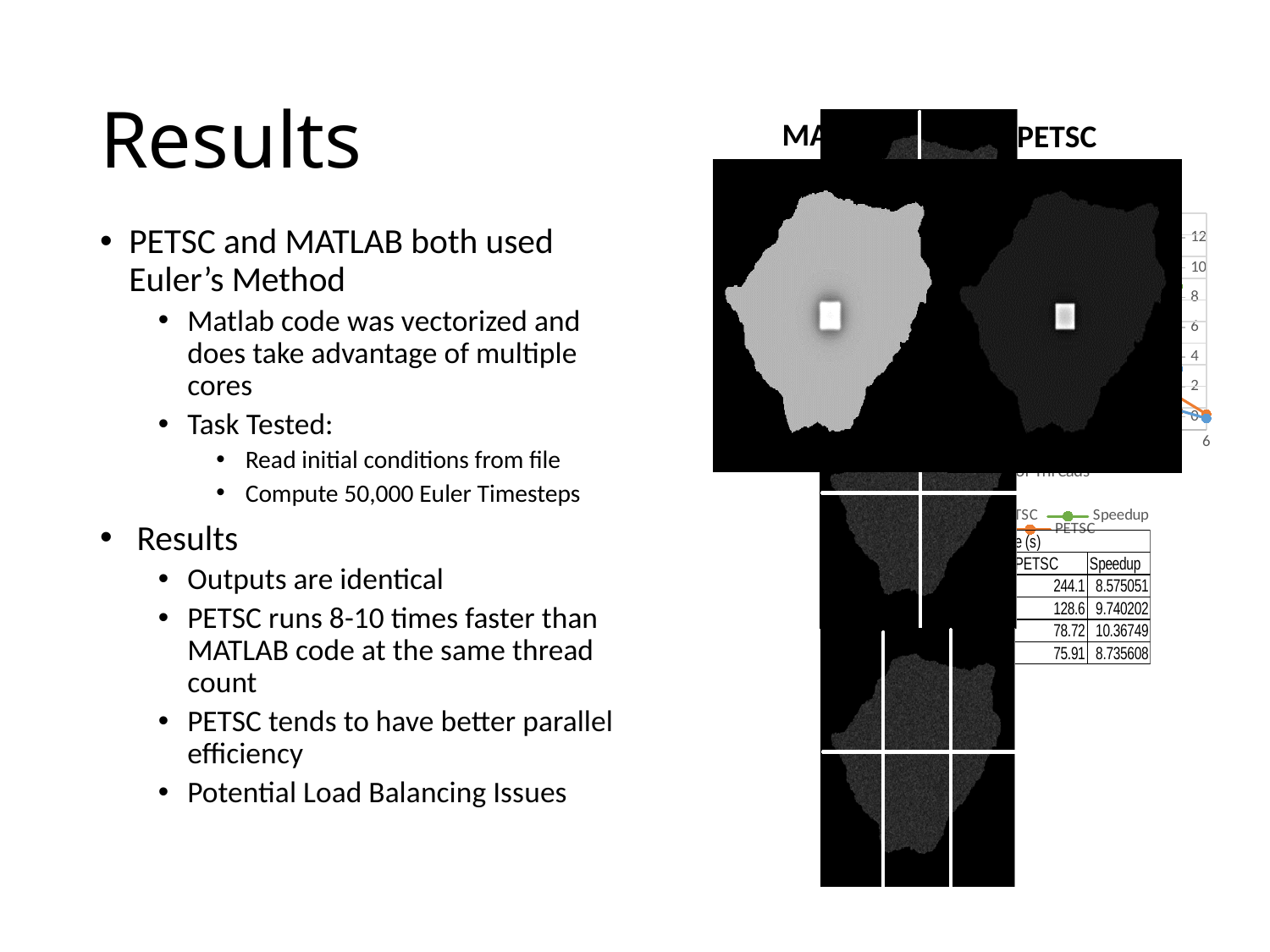
What is the highest tick value shown on the right-hand vertical axis of the chart? 12 In the data table beside the chart, what Speedup value is listed in the same row as the PETSC value 78.72? 10.36749 In the data table beside the chart, what is the largest Speedup value listed? 10.36749 In the data table beside the chart, what is the difference between the PETSC values 244.1 and 128.6? 115.5 In the data table beside the chart, what Speedup value is listed in the same row as the PETSC value 128.6? 9.740202 In the data table beside the chart, what is the smallest PETSC value listed? 75.91 Which legend entry of the chart is drawn with a green line and marker? Speedup In the data table beside the chart, how many rows of PETSC values are listed? 4 In the data table beside the chart, what is the largest PETSC value listed? 244.1 In the data table beside the chart, what is the smallest Speedup value listed? 8.575051 In the data table beside the chart, which is larger: the Speedup value 9.740202 or the Speedup value 8.735608? 9.740202